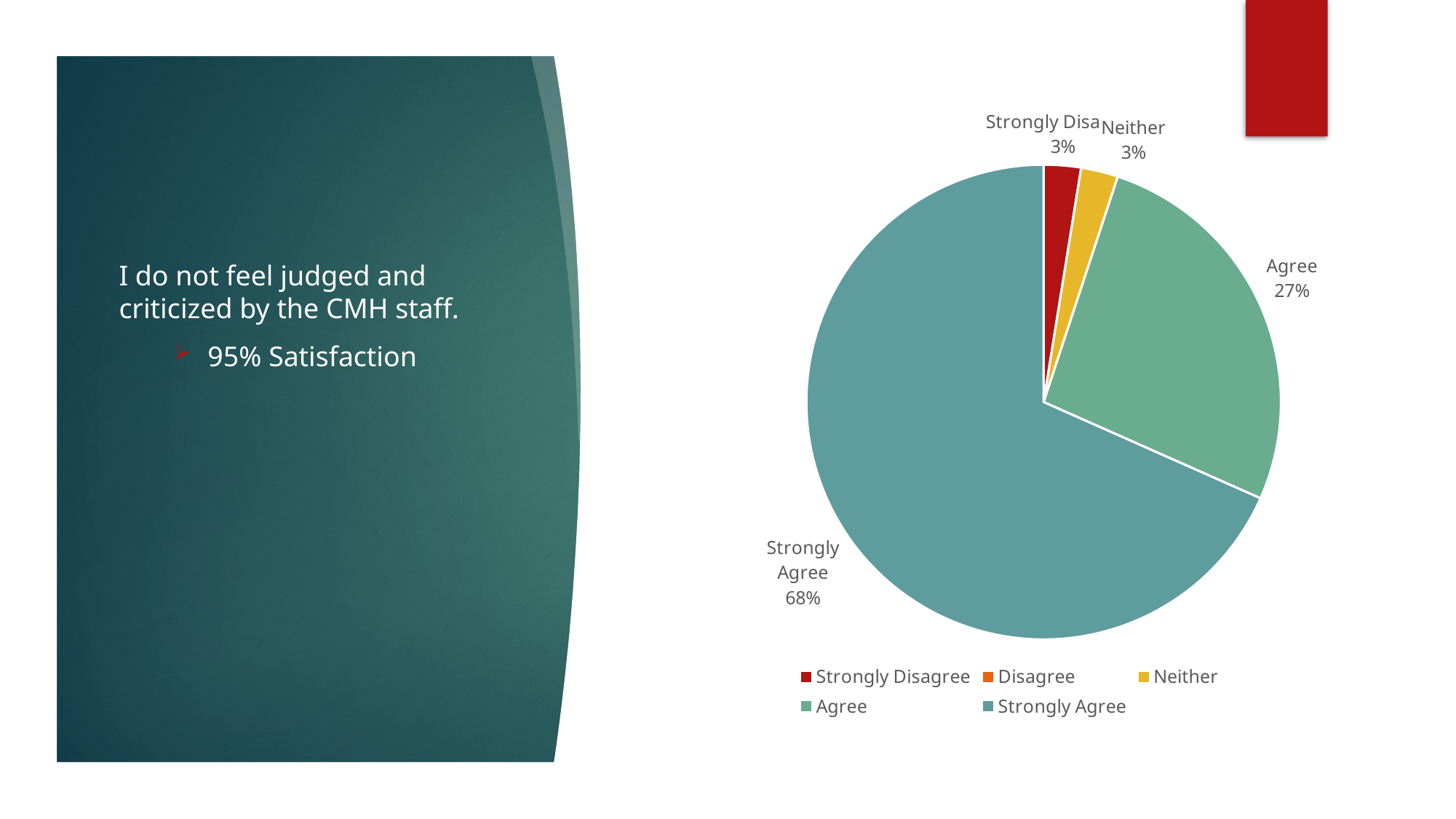
What percentage of respondents chose Strongly Disagree? 3% Which legend entry has no visible slice in the pie? Disagree What percentage of respondents chose Agree? 27% What is the combined share of Strongly Agree and Agree? 95% Which response category has the largest share of the pie? Strongly Agree What is the difference in percentage points between Strongly Agree and Agree? 41 What colour is the Strongly Disagree slice? dark red What kind of chart is shown on the slide? pie chart Which is larger, the share for Agree or the share for Strongly Agree? Strongly Agree What percentage of respondents chose Neither? 3% How many entries does the legend list? 5 What percentage of respondents chose Strongly Agree? 68%